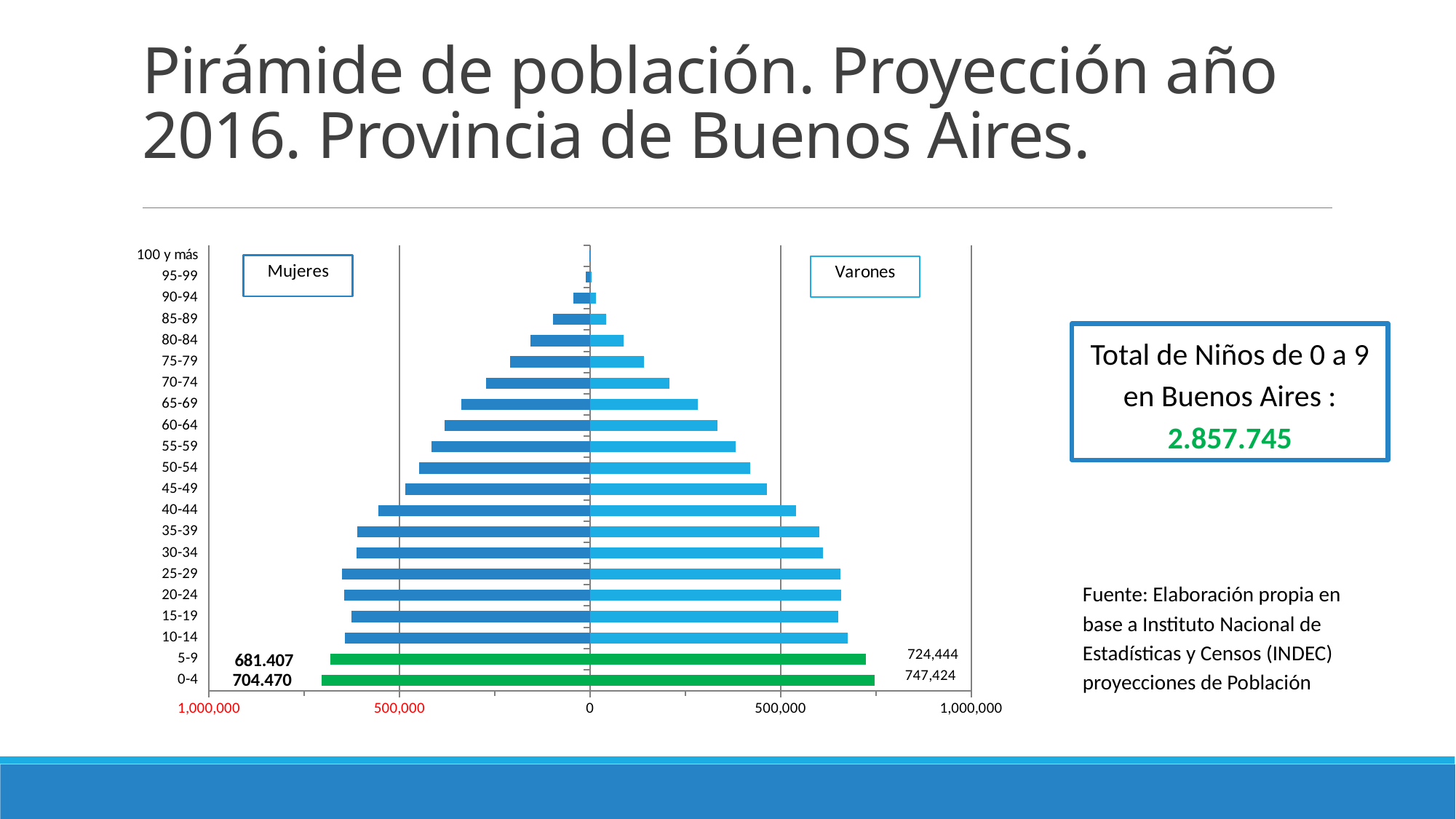
What is the value for Varones in the 5-9 age group? 724,444 What is the value for Mujeres in the 5-9 age group? 681.407 What is the difference between Varones and Mujeres in the 5-9 age group? 43,037 What kind of chart is shown on the slide? Bar chart What is the value for Mujeres in the 0-4 age group? 704.470 Is the value for Varones in the 40-44 age group greater or less than 500,000? greater What is the difference between Varones and Mujeres in the 0-4 age group? 42,954 What is the value for Varones in the 0-4 age group? 747,424 What colour are the bars for the 0-4 and 5-9 age groups? Green Which age group has the largest Varones bar? 0-4 How many age groups are shown on the vertical axis of the chart? 21 In the 0-4 age group, which is larger, Mujeres or Varones? Varones